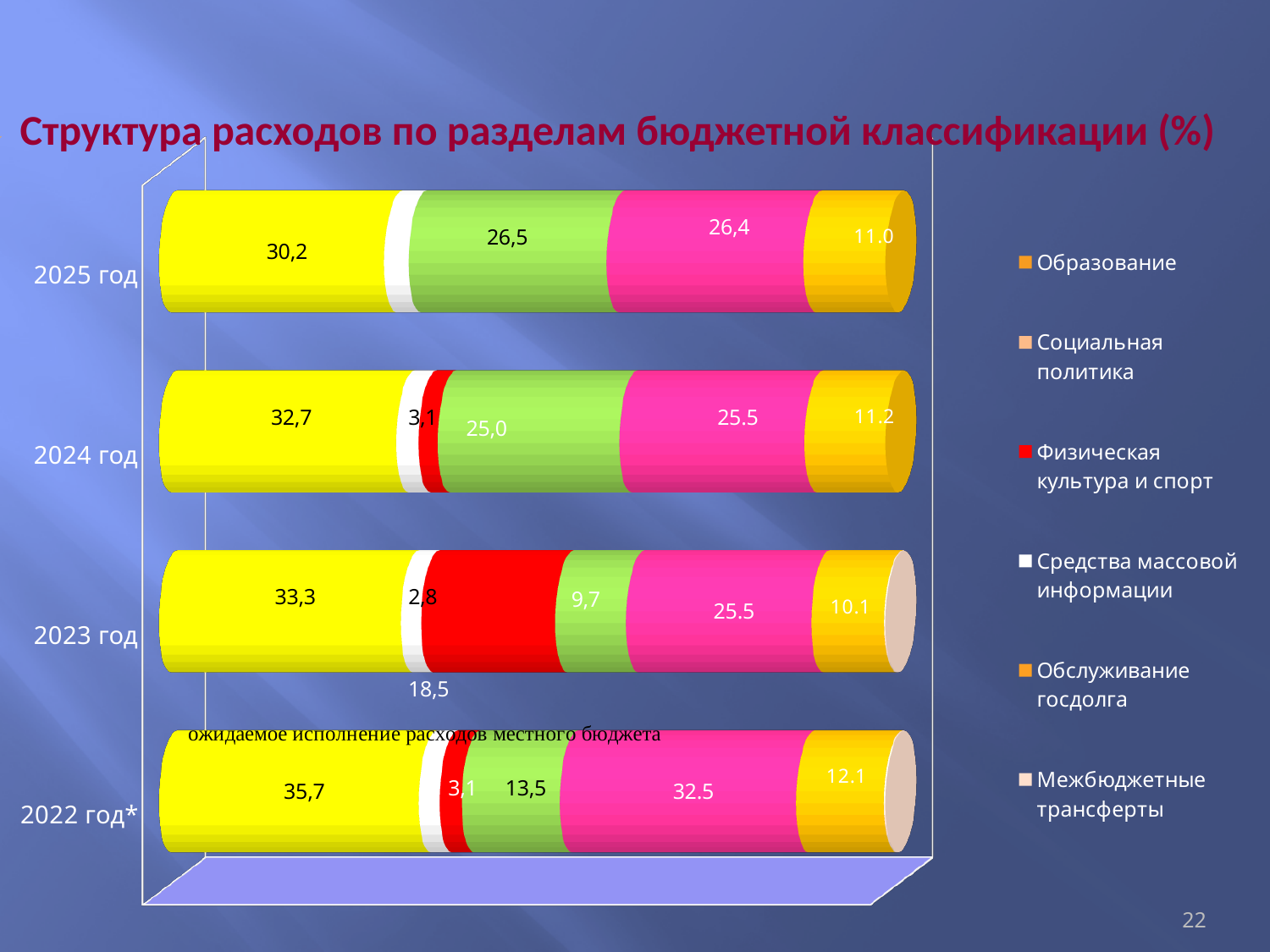
What is the value of the yellow segment for 2022 год*? 35,7 Does the yellow segment rise or fall from 2022 год* to 2025 год? fall Which year has the largest yellow segment? 2022 год* What is the difference between the yellow segment for 2022 год* and the yellow segment for 2025 год? 5,5 What kind of chart is shown on the slide? stacked bar chart What is the title of the chart? Структура расходов по разделам бюджетной классификации (%) What is the value of the last (orange) segment for 2022 год*? 12.1 What is the value of the red segment for 2023 год? 18,5 How many years (categories) are shown on the chart? 4 How many series does the legend list? 6 Which year has the larger yellow segment, 2024 год or 2023 год? 2023 год What is the value of the yellow segment for 2025 год? 30,2